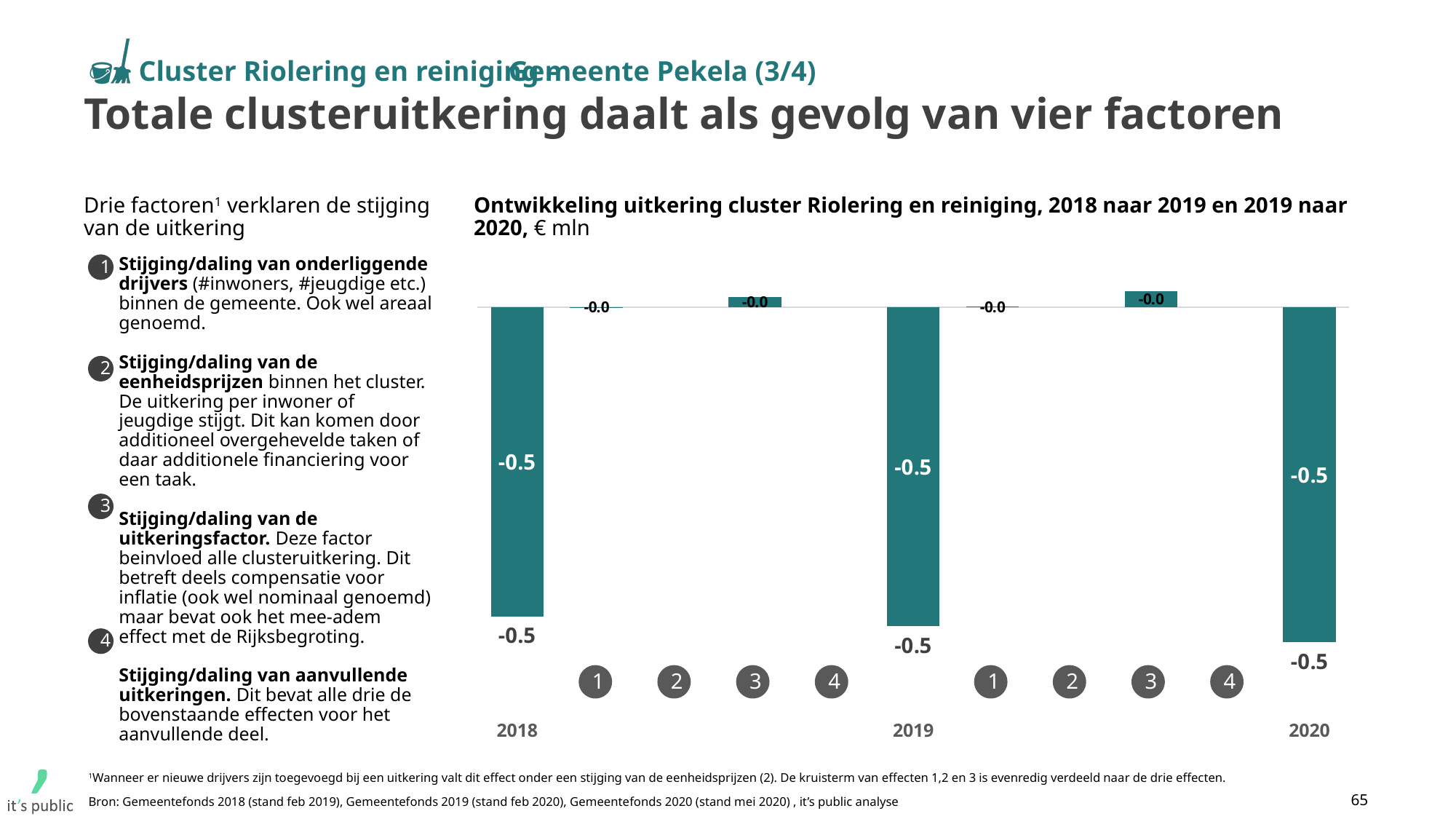
What is the title of the chart? Ontwikkeling uitkering cluster Riolering en reiniging, 2018 naar 2019 en 2019 naar 2020 What is the value shown for 2018 in the chart? -0.5 What value is labelled on the bar for factor 1 between 2018 and 2019? -0.0 In what unit are the values in the chart expressed? € mln What is the value shown for 2019 in the chart? -0.5 What is the value shown for 2020 in the chart? -0.5 What kind of chart is shown on the slide? Bar chart What value is labelled on the bar for factor 3 between 2019 and 2020? -0.0 How many numbered factor markers are shown between 2018 and 2019 in the chart? 4 How many years are labelled on the x axis of the chart? 3